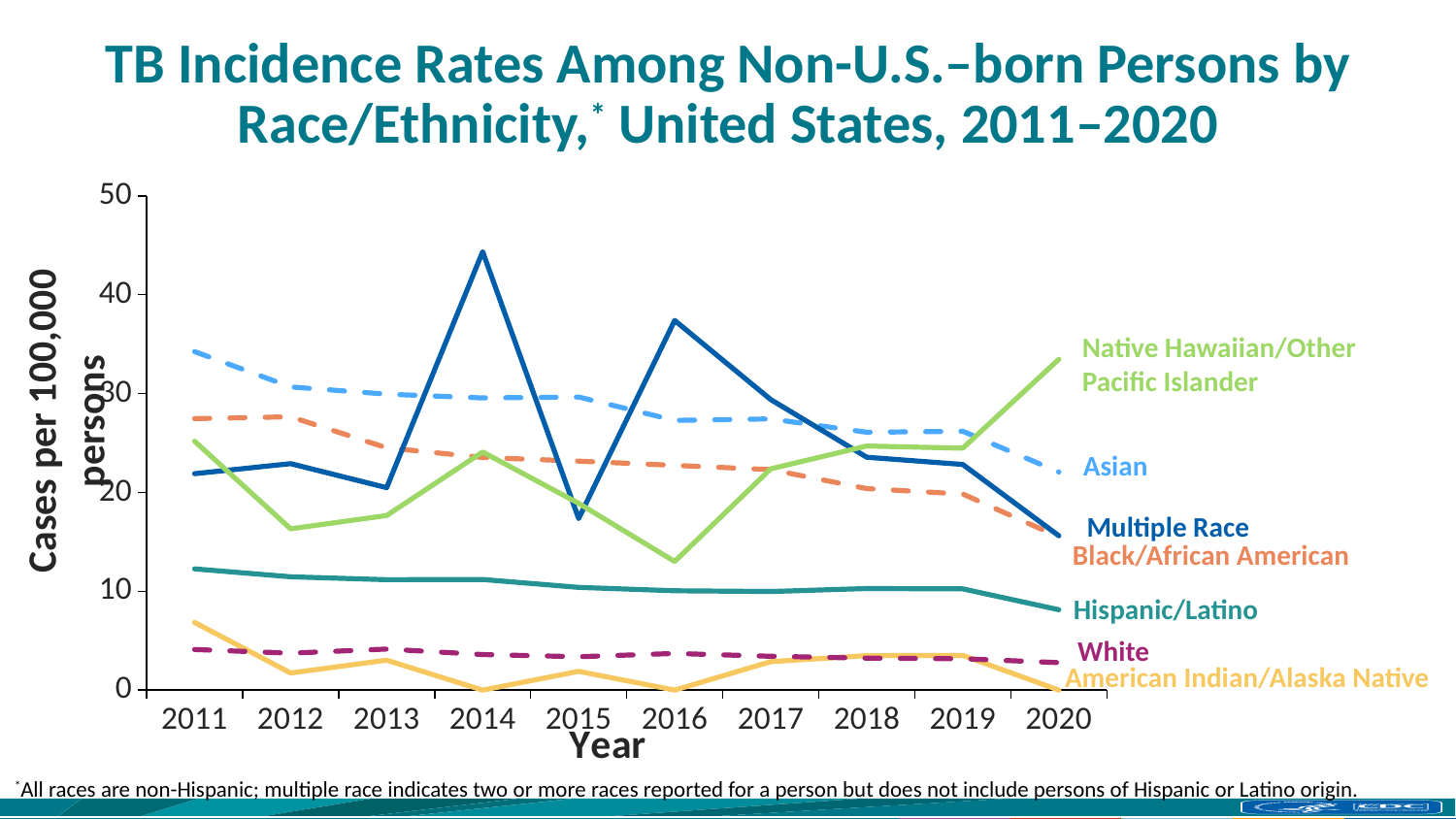
How many years are shown along the x axis? 10 Is the value for Multiple Race in 2014 greater or less than 40? greater Is the value for Asian in 2011 greater or less than 30? greater Which race/ethnicity group has the lowest TB incidence rate in 2020? American Indian/Alaska Native How many race/ethnicity series are plotted on the chart? 7 Which race/ethnicity group has the highest TB incidence rate in 2020? Native Hawaiian/Other Pacific Islander Does the TB incidence rate for Asian persons generally rise or fall from 2011 to 2020? Fall Is the value for Hispanic/Latino in 2020 greater or less than 10? less What kind of chart is shown on the slide? Line chart In 2016, which is larger: the rate for Multiple Race or the rate for Asian? Multiple Race Which race/ethnicity group has the highest TB incidence rate in 2014? Multiple Race